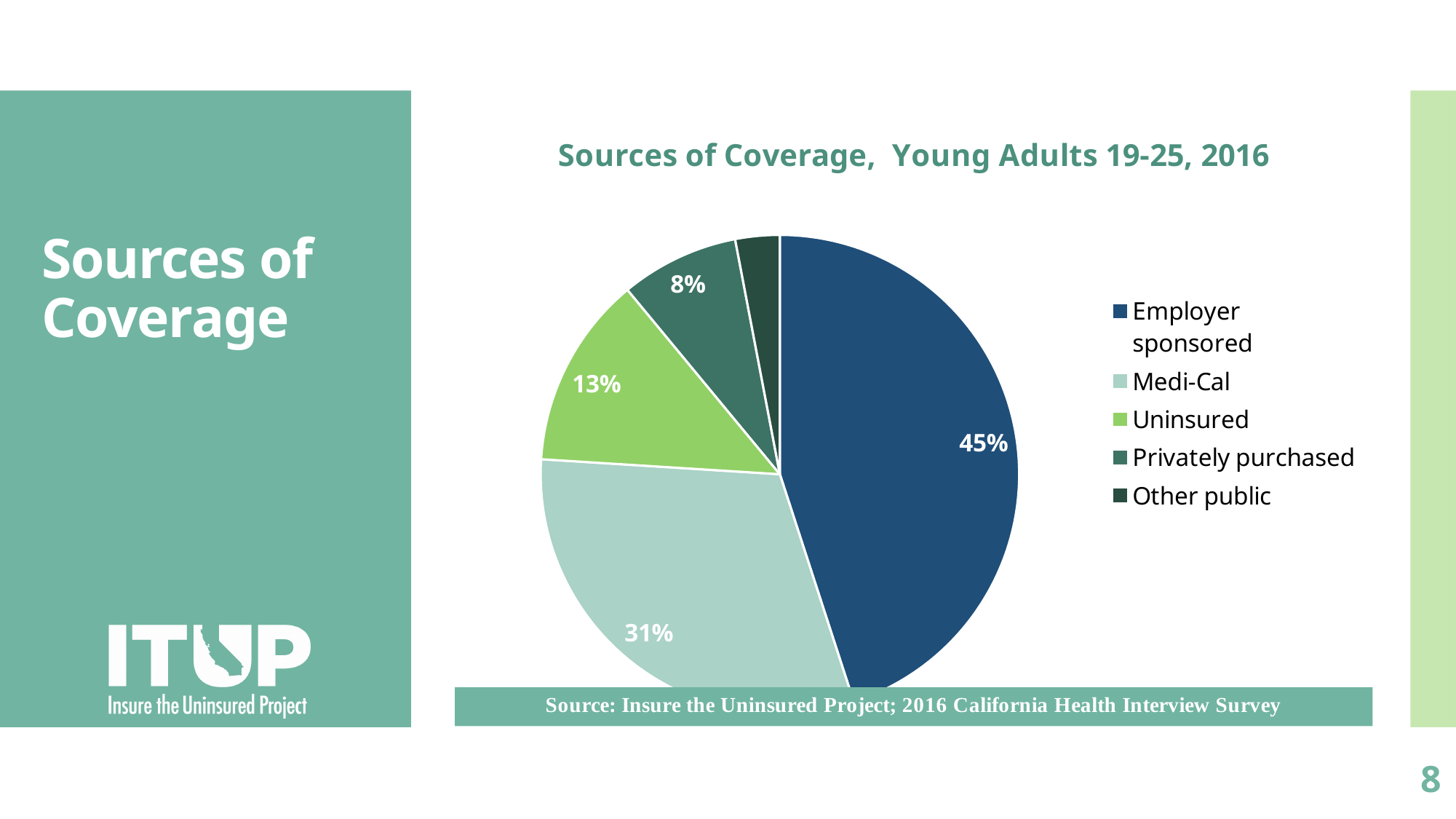
What share of young adults 19-25 had employer sponsored coverage in 2016? 45% How many categories does the legend list? 5 Which is larger, the share for Uninsured or the share for Privately purchased? Uninsured What colour is the Medi-Cal slice? Light green What percentage of young adults 19-25 were uninsured? 13% What is the difference in percentage points between employer sponsored coverage and Medi-Cal? 14 percentage points What type of chart is shown on the slide? Pie chart What share of young adults had privately purchased coverage? 8% What percentage of young adults 19-25 were covered by Medi-Cal? 31% Which source of coverage has the smallest share of the pie? Other public What is the title of the chart? Sources of Coverage, Young Adults 19-25, 2016 Which source of coverage has the largest share of the pie? Employer sponsored